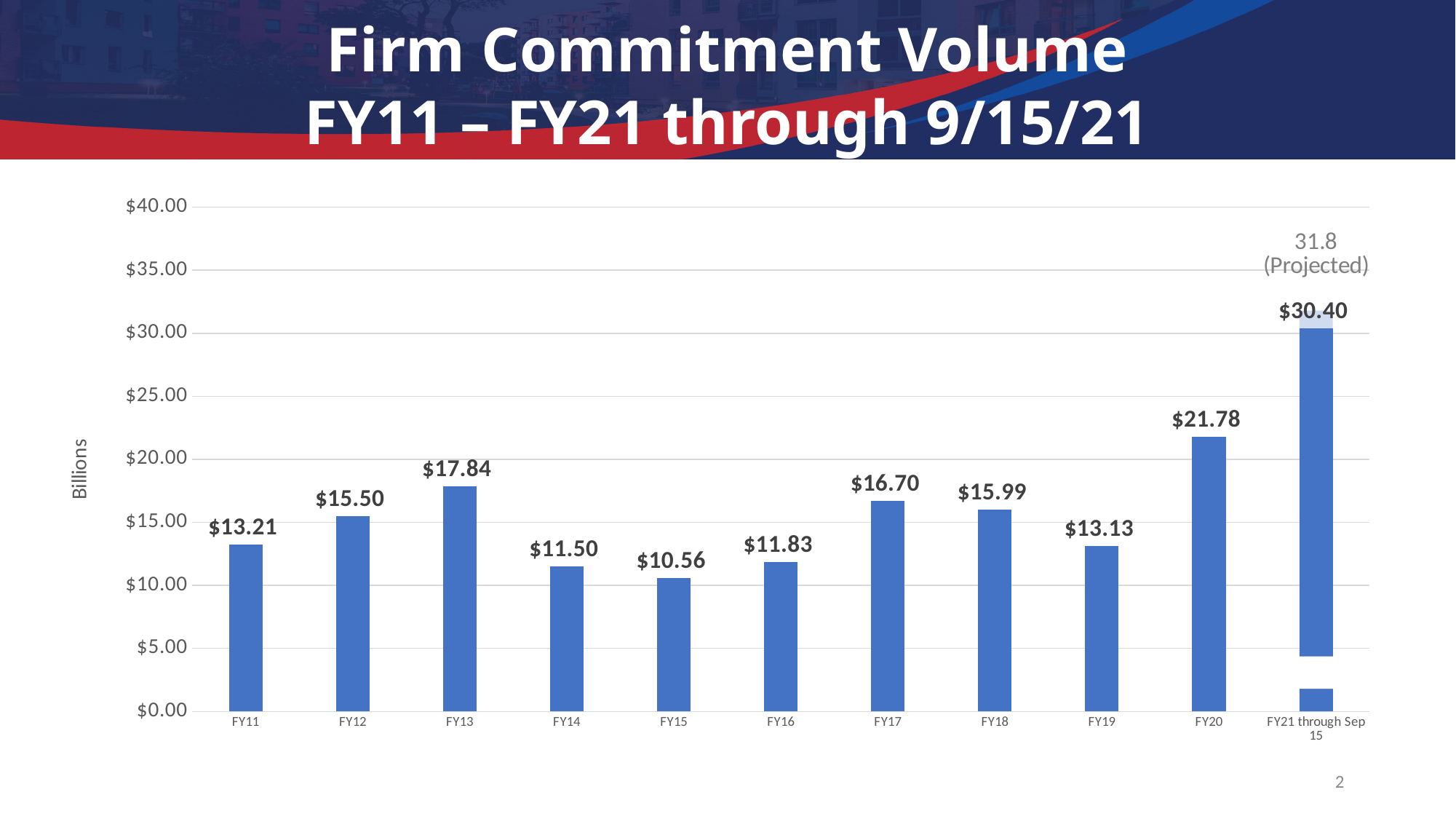
What is the value shown for FY20? $21.78 What is the value shown for FY21 through Sep 15? $30.40 What is the difference between the FY20 value and the FY19 value? $8.65 Which fiscal year has the lowest firm commitment volume? FY15 How many fiscal year categories are shown on the x axis? 11 Is the value for FY14 greater or less than $15.00? less What kind of chart is shown on the slide? bar chart Which is larger, the value for FY17 or the value for FY18? FY17 Which category has the highest bar on the chart? FY21 through Sep 15 Do the values rise or fall from FY13 to FY15? fall What is the firm commitment volume for FY13? $17.84 What is the projected value noted above the FY21 bar? 31.8 (Projected)